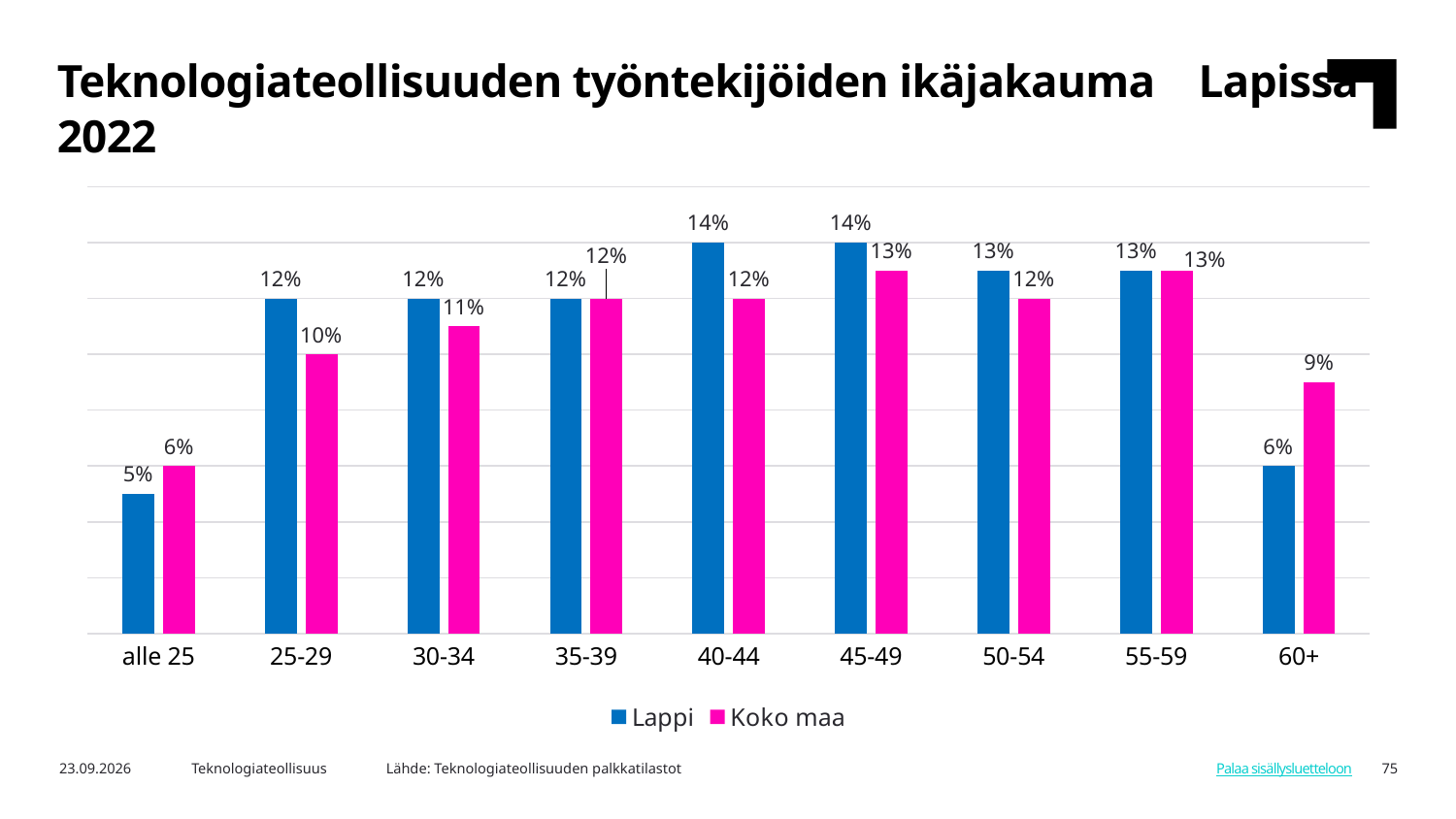
What is the difference between Lappi and Koko maa in the 60+ age group? 3% Which is larger in the 60+ age group, Lappi or Koko maa? Koko maa How many series does the legend list? 2 What is the value for Lappi in the 40-44 age group? 14% Which is larger in the 25-29 age group, Lappi or Koko maa? Lappi What is the value for Koko maa in the 25-29 age group? 10% What is the value for Koko maa in the 60+ age group? 9% Which age group has the lowest value for Lappi? alle 25 Which age group has the lowest value for Koko maa? alle 25 What kind of chart is shown on the slide? bar chart Which series is shown in pink? Koko maa How many age categories are shown on the x axis? 9